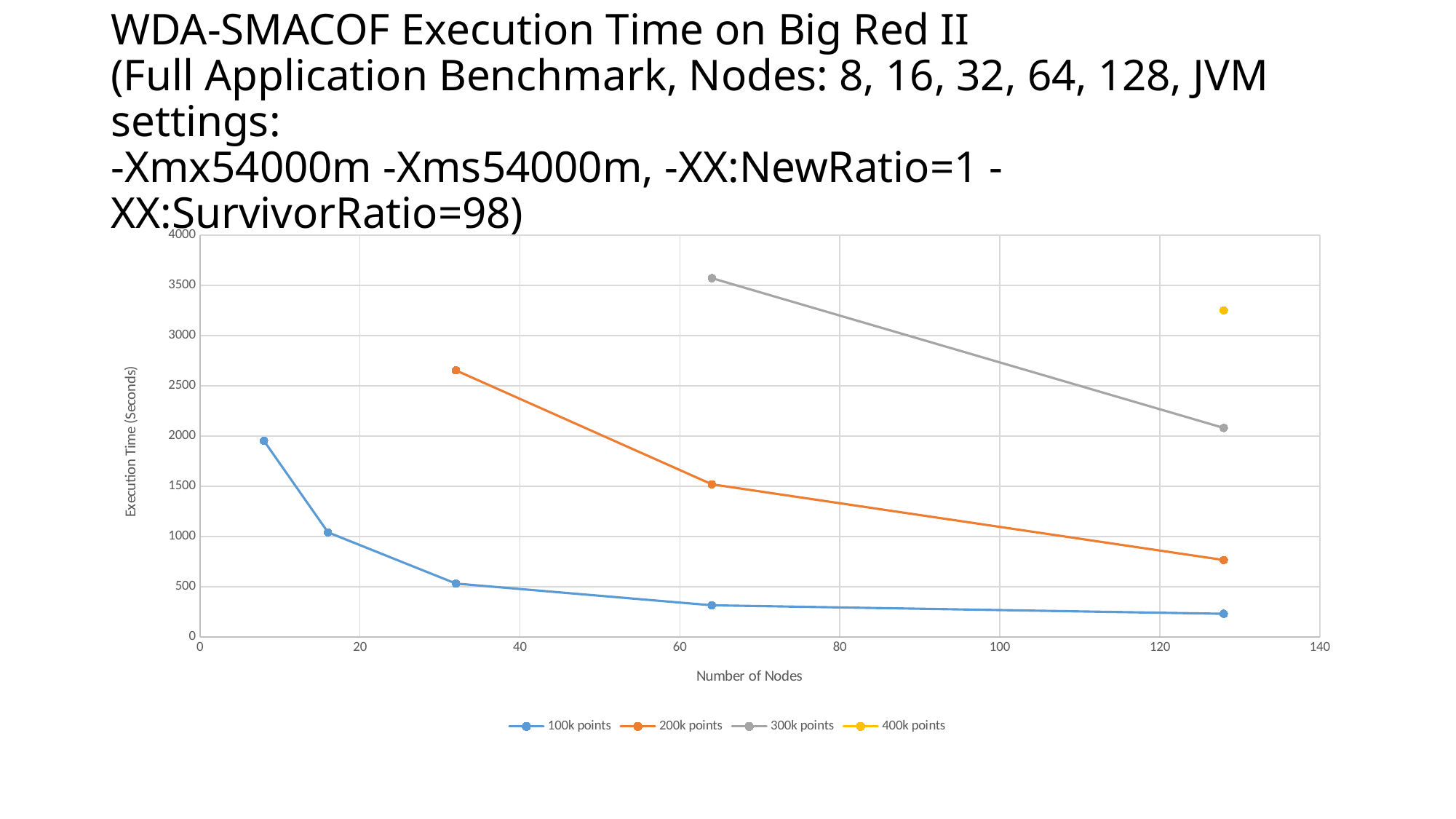
Does the execution time for the 100k points series rise or fall as the number of nodes increases? fall What is the label of the vertical axis? Execution Time (Seconds) Is the execution time for the 400k points series at 128 nodes greater or less than 3000? greater Which series has the lowest execution time at 128 nodes? 100k points At 128 nodes, which series has the larger execution time, 300k points or 400k points? 400k points How many data points are plotted for the 100k points series? 5 What kind of chart is shown on the slide? line chart Is the execution time for the 100k points series at 64 nodes greater or less than 500? less Is the execution time for the 200k points series at 128 nodes greater or less than 1000? less How many series does the legend list? 4 Which series has the highest execution time at 128 nodes? 400k points